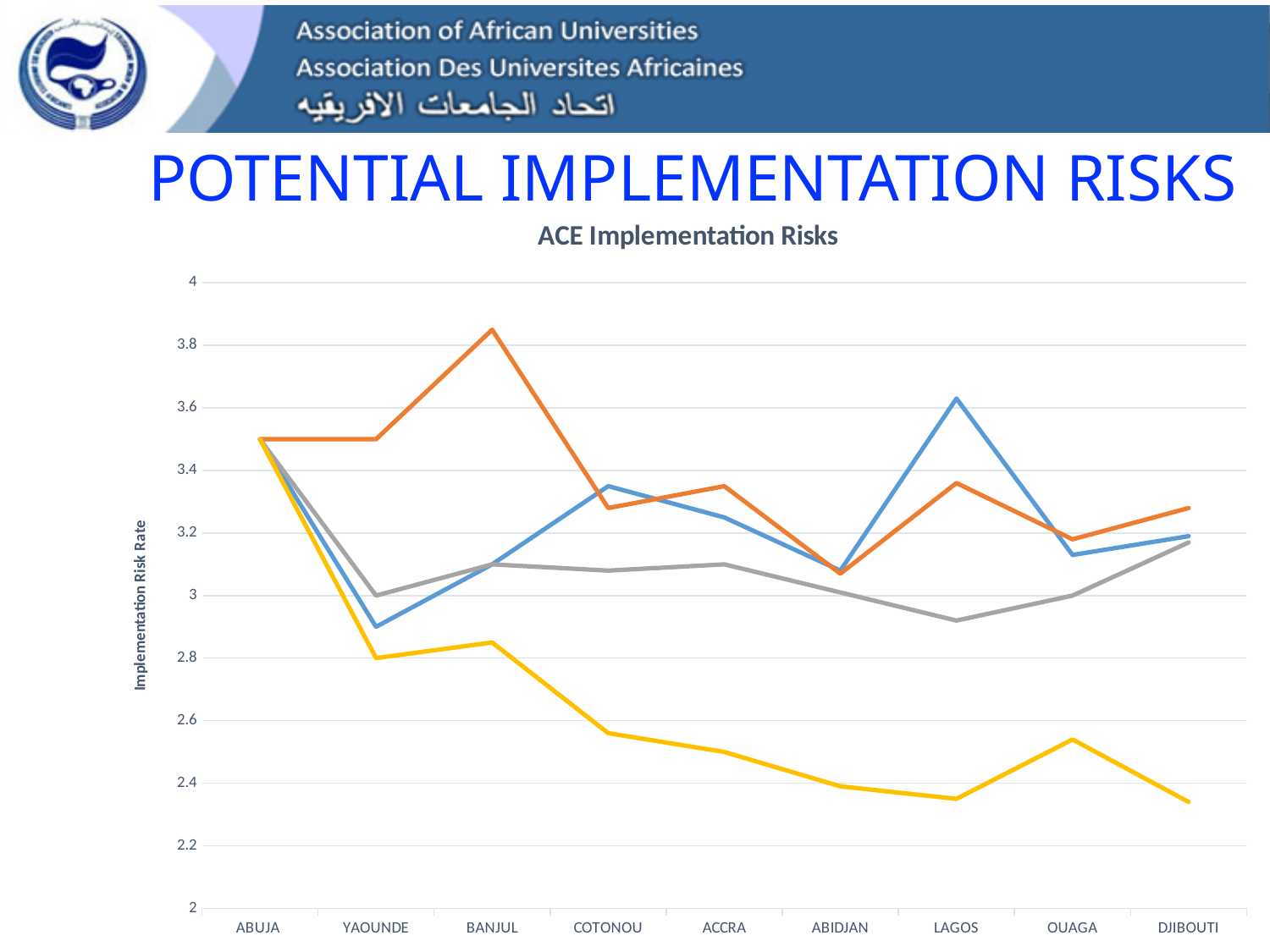
At which city does the grey line reach its lowest value? LAGOS What kind of chart is shown on the slide? line chart Is the value of the yellow line at LAGOS greater or less than 2.4? less Does the yellow line generally rise or fall from ABUJA to DJIBOUTI? fall Is the value of the orange line at BANJUL greater or less than 3.6? greater What is the label on the vertical axis of the chart? Implementation Risk Rate At which city does the orange line reach its highest value? BANJUL At which city does the blue line reach its highest value? LAGOS How many cities are listed along the x axis of the chart? 9 At LAGOS, which line has the higher value, the blue line or the grey line? blue line How many lines are plotted on the chart? 4 What is the title of the chart? ACE Implementation Risks